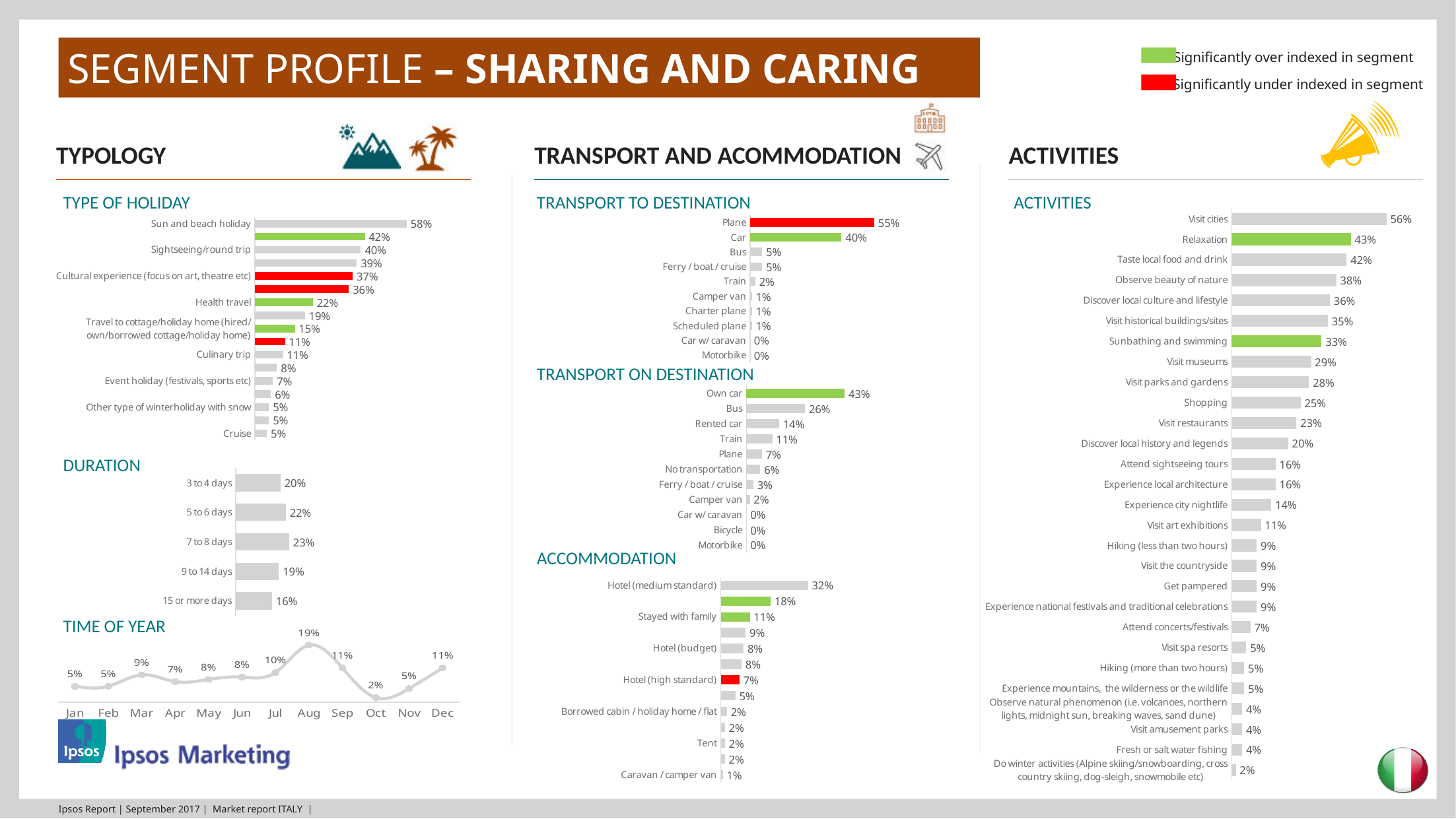
In the Type of Holiday chart, what is the value for Sun and beach holiday? 58% In the Activities chart, what is the difference between the values for Visit cities and Relaxation? 13% In the Transport to Destination chart, what is the value for Car? 40% What kind of chart is the Time of Year chart? line chart In the Duration chart, which category has the highest value? 7 to 8 days In the Time of Year chart, what is the value for Oct? 2% In the Transport on Destination chart, how many categories are shown? 11 In the Activities chart, what is the value for Sunbathing and swimming? 33% In the Accommodation chart, what is the value for Hotel (medium standard)? 32% In the Transport on Destination chart, which is larger, Bus or Rented car? Bus In the Time of Year chart, which month has the highest value? Aug In the Duration chart, what is the difference between the values for 7 to 8 days and 15 or more days? 7%